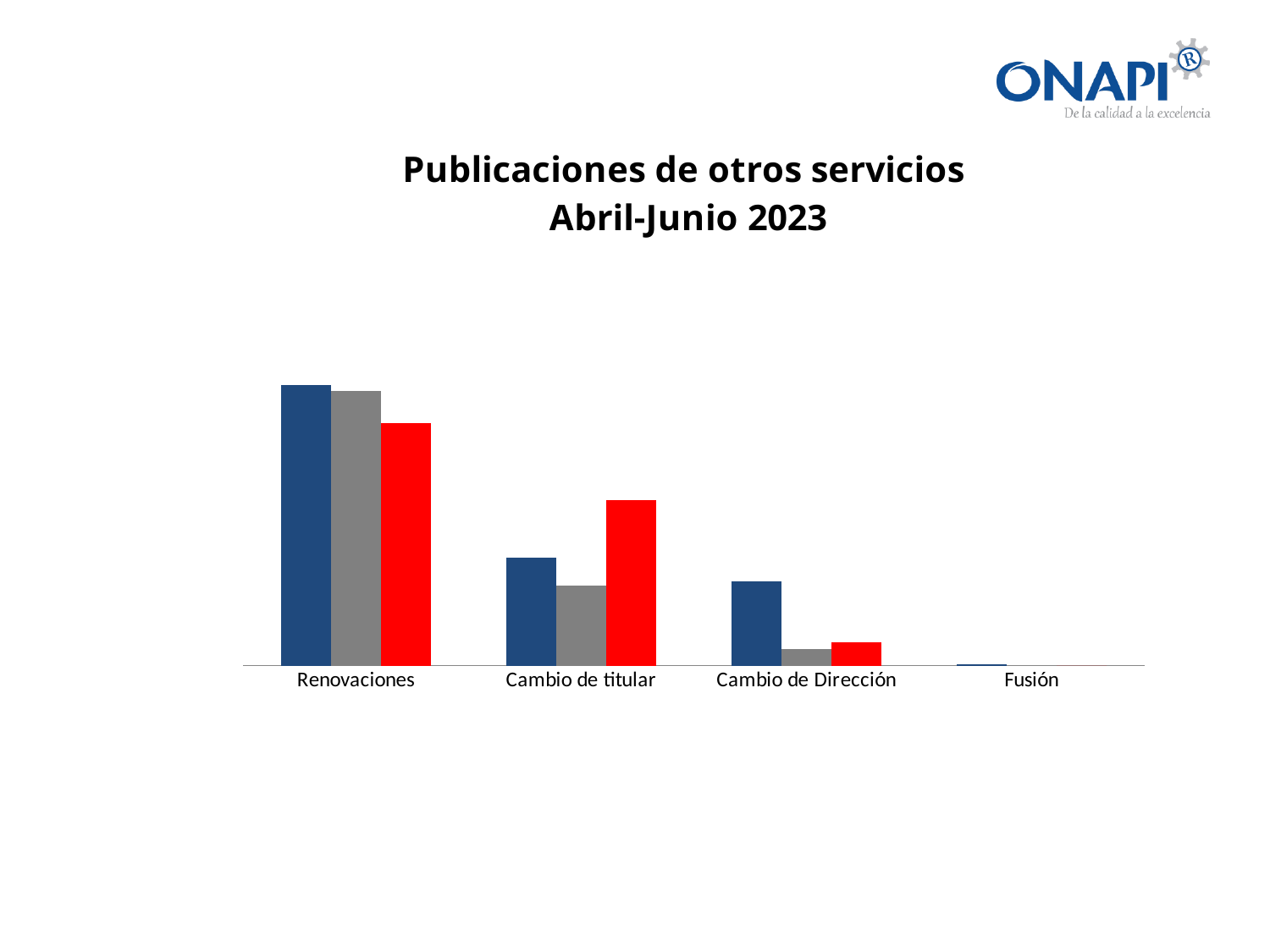
How many categories are shown on the x axis of the chart? 4 For Cambio de Dirección, which bar is taller: the blue bar or the gray bar? The blue bar For Cambio de titular, which bar is taller: the red bar or the gray bar? The red bar Do the values of the blue bars rise or fall from Renovaciones to Fusión along the x axis? Fall For Renovaciones, which bar is taller: the blue bar or the red bar? The blue bar What colours are the three bars in each category of the chart? Blue, gray and red Which category has the highest values in the chart? Renovaciones What kind of chart is shown on the slide? Bar chart Which category has the tallest red bar? Renovaciones How many bars are plotted for each category in the chart? 3 What is the title of the chart? Publicaciones de otros servicios Abril-Junio 2023 Which category has the lowest values in the chart? Fusión